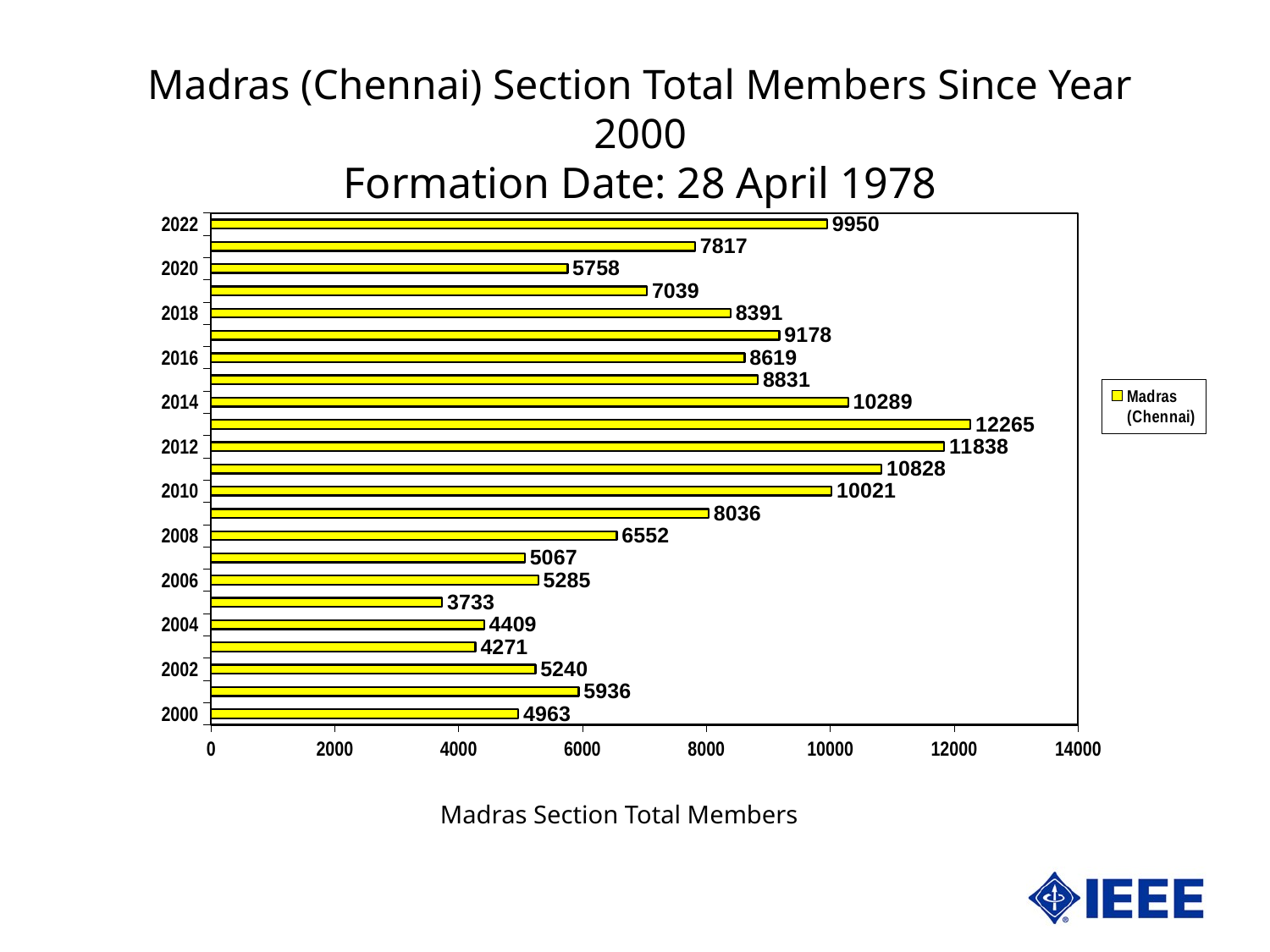
What is the value for 2022? 9950 How many series does the legend list? 1 What is the x-axis label of the chart? Madras Section Total Members What is the smallest value shown on the chart? 3733 What type of chart is shown on the slide? bar chart Is the value for 2014 greater or less than 10000? greater What is the value for 2012? 11838 What is the difference between the values for 2022 and 2020? 4192 What is the largest value shown on the chart? 12265 What is the value for 2000? 4963 Which is larger, the value for 2010 or the value for 2016? 2010 What is the value for 2020? 5758